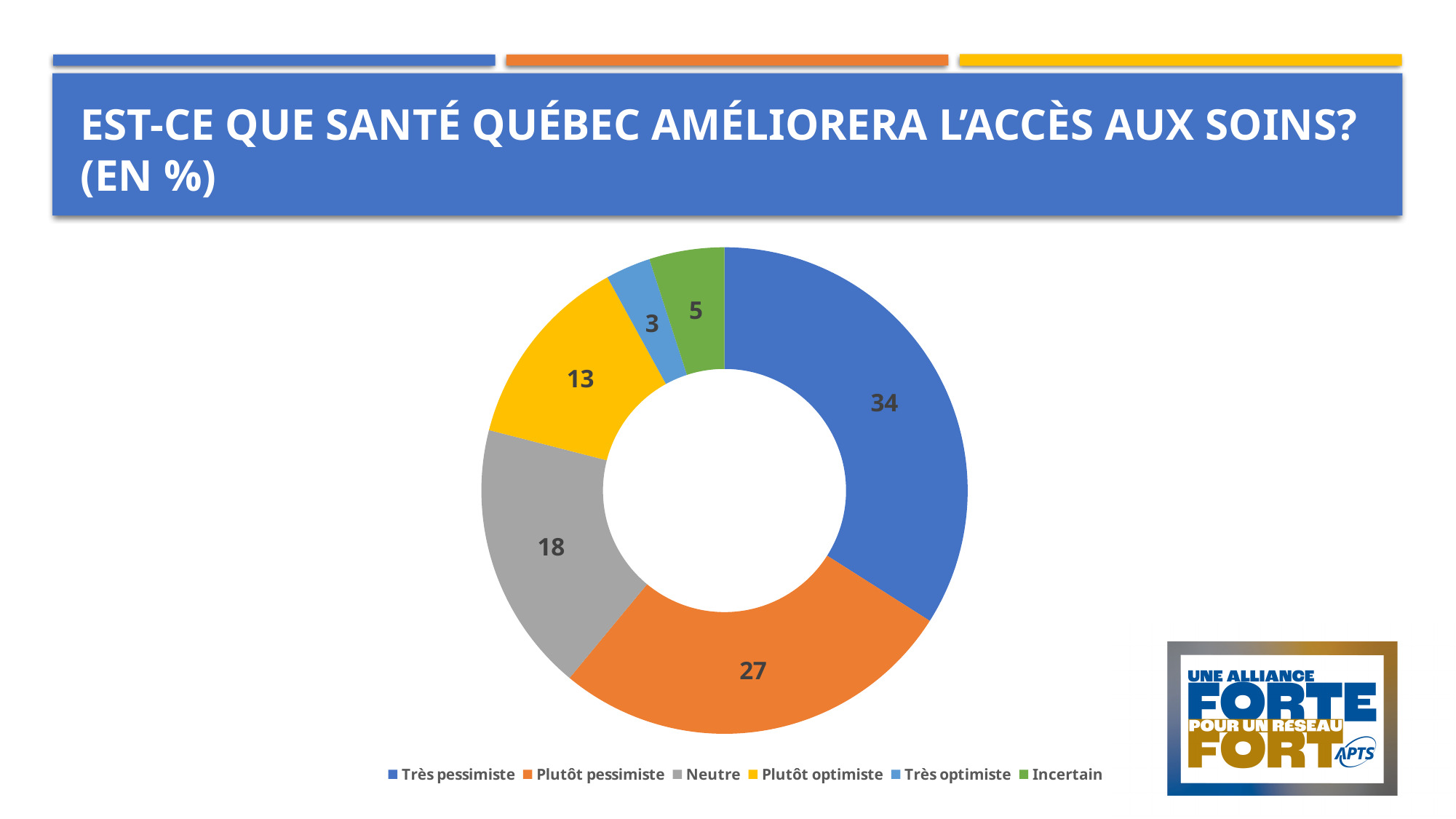
What value is shown for Très pessimiste? 34 What is the difference between the values for Très pessimiste and Plutôt pessimiste? 7 How many categories does the chart show? 6 Which category has the largest share of the chart? Très pessimiste What value is shown for Incertain? 5 What colour is the Incertain segment? Green What value is shown for Plutôt optimiste? 13 Which is larger, the value for Neutre or the value for Plutôt optimiste? Neutre What value is shown for Plutôt pessimiste? 27 What kind of chart is shown on the slide? Doughnut chart Which category has the smallest share of the chart? Très optimiste What value is shown for Neutre? 18